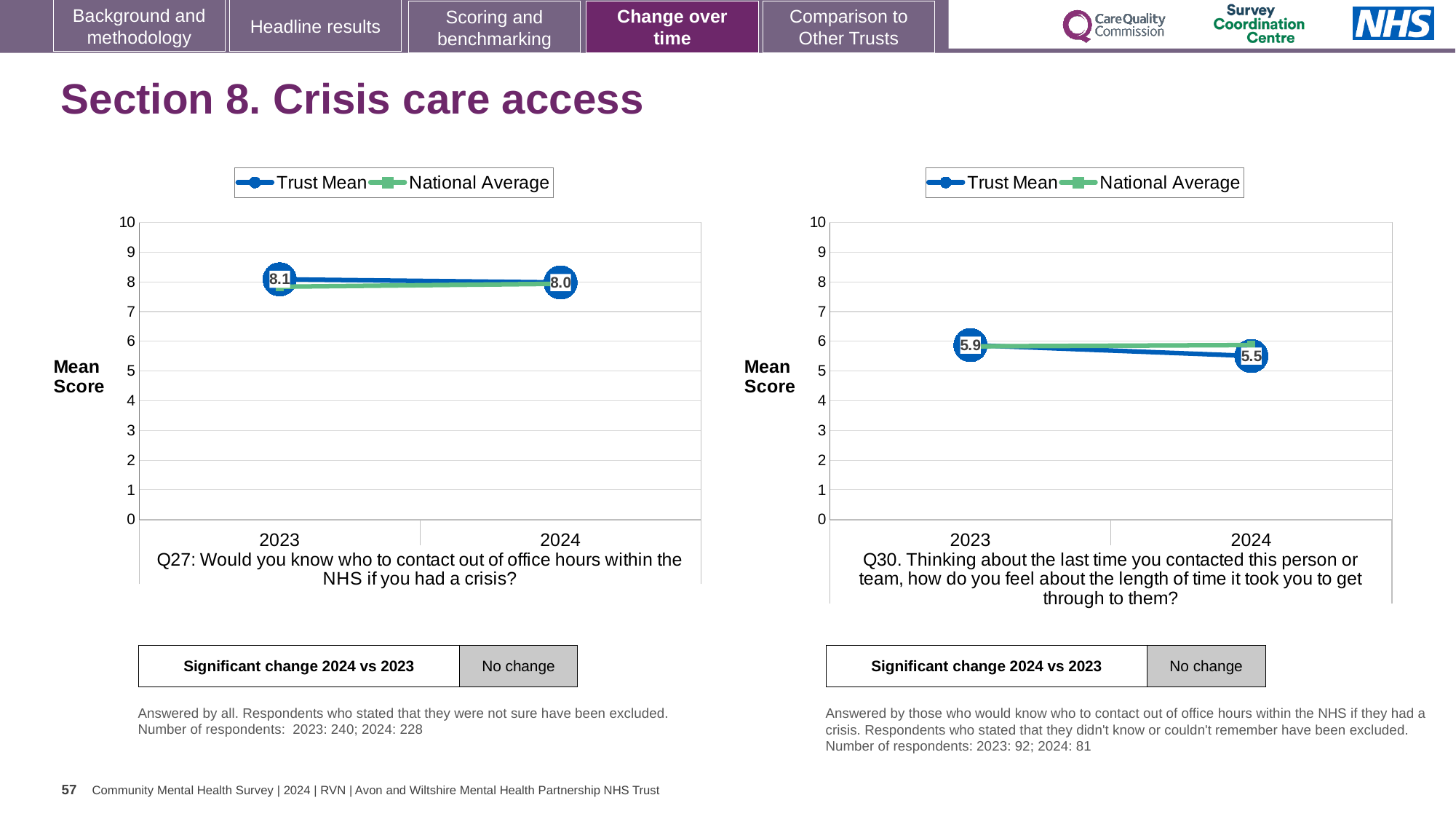
In the Q30 chart (right), what is the Trust Mean score for 2023? 5.9 How many series does the legend of the Q27 chart (left) list? 2 In the Q27 chart (left), is the National Average for 2023 greater or less than 7? greater In the Q30 chart (right), which year has the higher Trust Mean score, 2023 or 2024? 2023 In the Q30 chart (right), is the National Average for 2024 greater or less than 7? less How many years are plotted on the x axis of the Q30 chart (right)? 2 In the Q27 chart (left), what is the Trust Mean score for 2024? 8.0 In the Q27 chart (left), what is the Trust Mean score for 2023? 8.1 What kind of chart is the Q27 chart (left)? line chart In the Q30 chart (right), what is the Trust Mean score for 2024? 5.5 In the Q27 chart (left), does the Trust Mean rise or fall from 2023 to 2024? fall In the Q30 chart (right), what is the difference between the Trust Mean scores for 2023 and 2024? 0.4